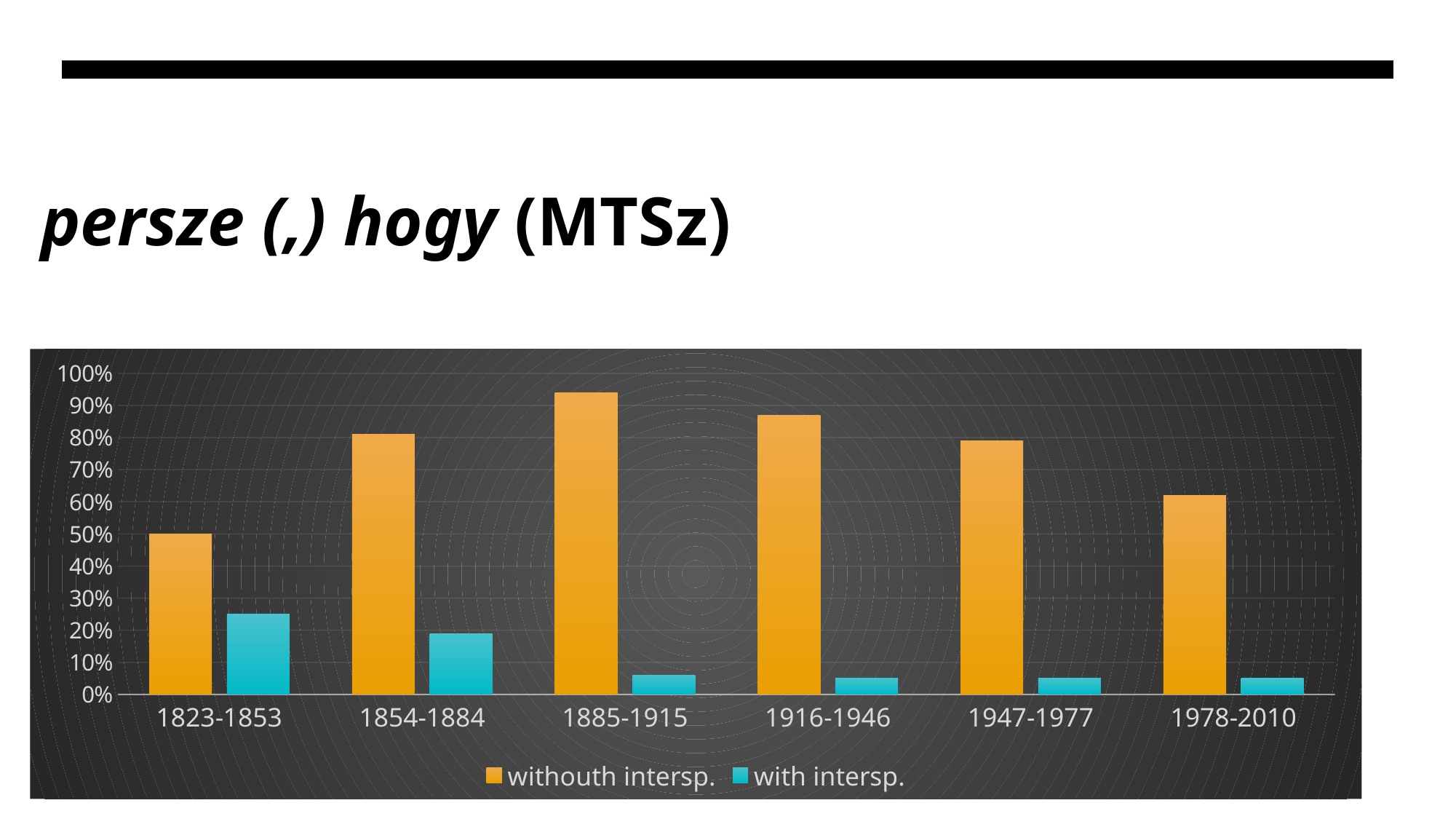
Is the 'with intersp.' value for 1823-1853 greater or less than 30%? less Is the 'withouth intersp.' value for 1978-2010 greater or less than 70%? less What colour are the bars for the 'with intersp.' series? cyan How many series does the chart's legend list? 2 Which period has the highest value for 'with intersp.'? 1823-1853 What kind of chart is shown on the slide? bar chart Is the 'withouth intersp.' value for 1885-1915 greater or less than 90%? greater Which period has the highest value for 'withouth intersp.'? 1885-1915 Which period has the lowest value for 'withouth intersp.'? 1823-1853 Which is larger for 'withouth intersp.': the value for 1916-1946 or the value for 1947-1977? 1916-1946 Do the 'with intersp.' values generally rise or fall from 1823-1853 to 1978-2010? fall How many time periods are shown on the x axis of the chart? 6